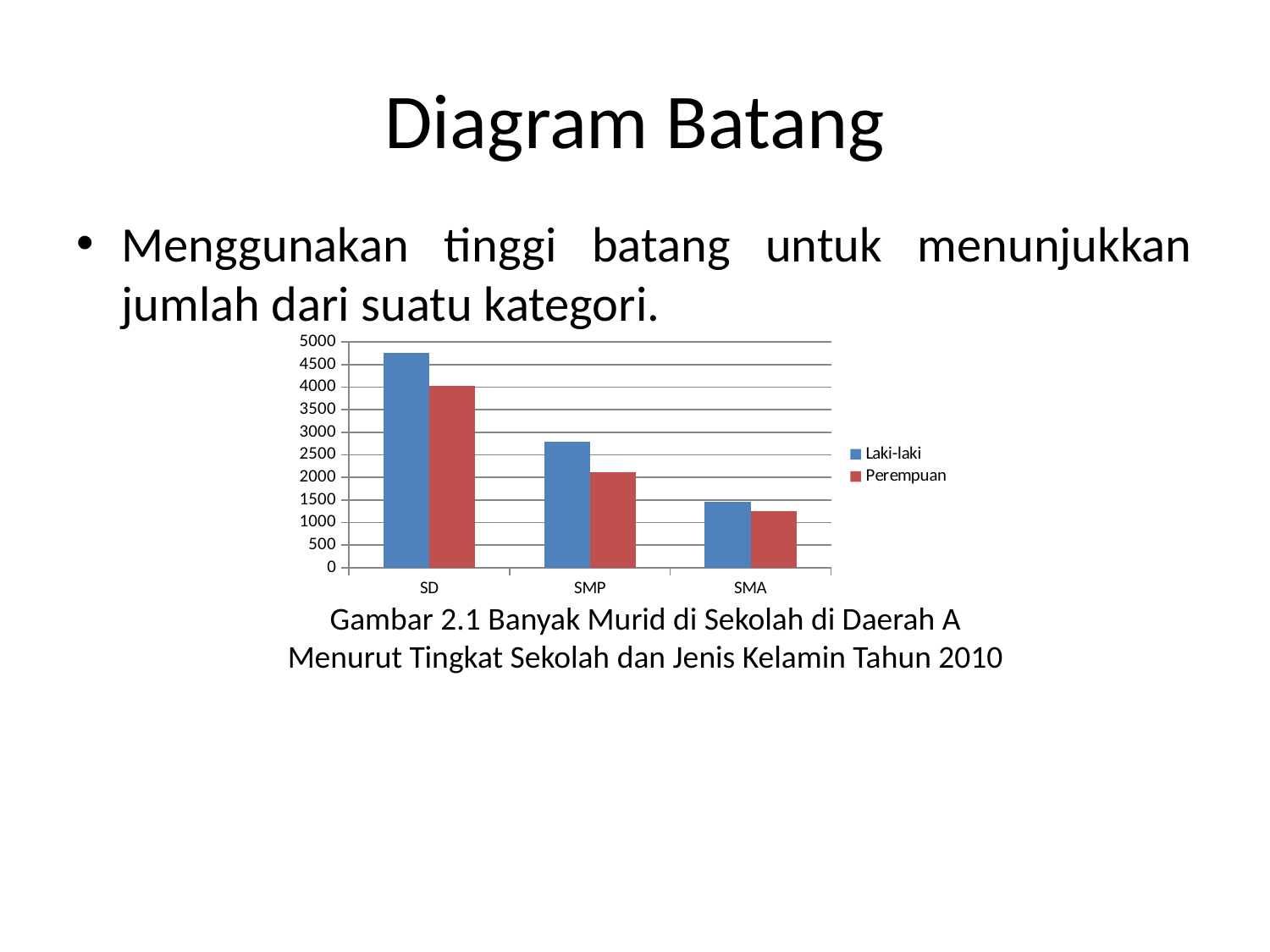
Which colour represents the Perempuan series in the legend? red Do the Laki-laki values rise or fall from SD to SMA? fall Which category has the highest Laki-laki value? SD Is the Perempuan value for SMA greater or less than 1500? less For SMP, which is larger: Laki-laki or Perempuan? Laki-laki What kind of chart is shown on the slide? bar chart Is the Laki-laki value for SD greater or less than 4500? greater How many school-level categories are shown on the x axis? 3 How many series does the legend list? 2 Is the Laki-laki value for SMP greater or less than 2500? greater Which category has the lowest Perempuan value? SMA